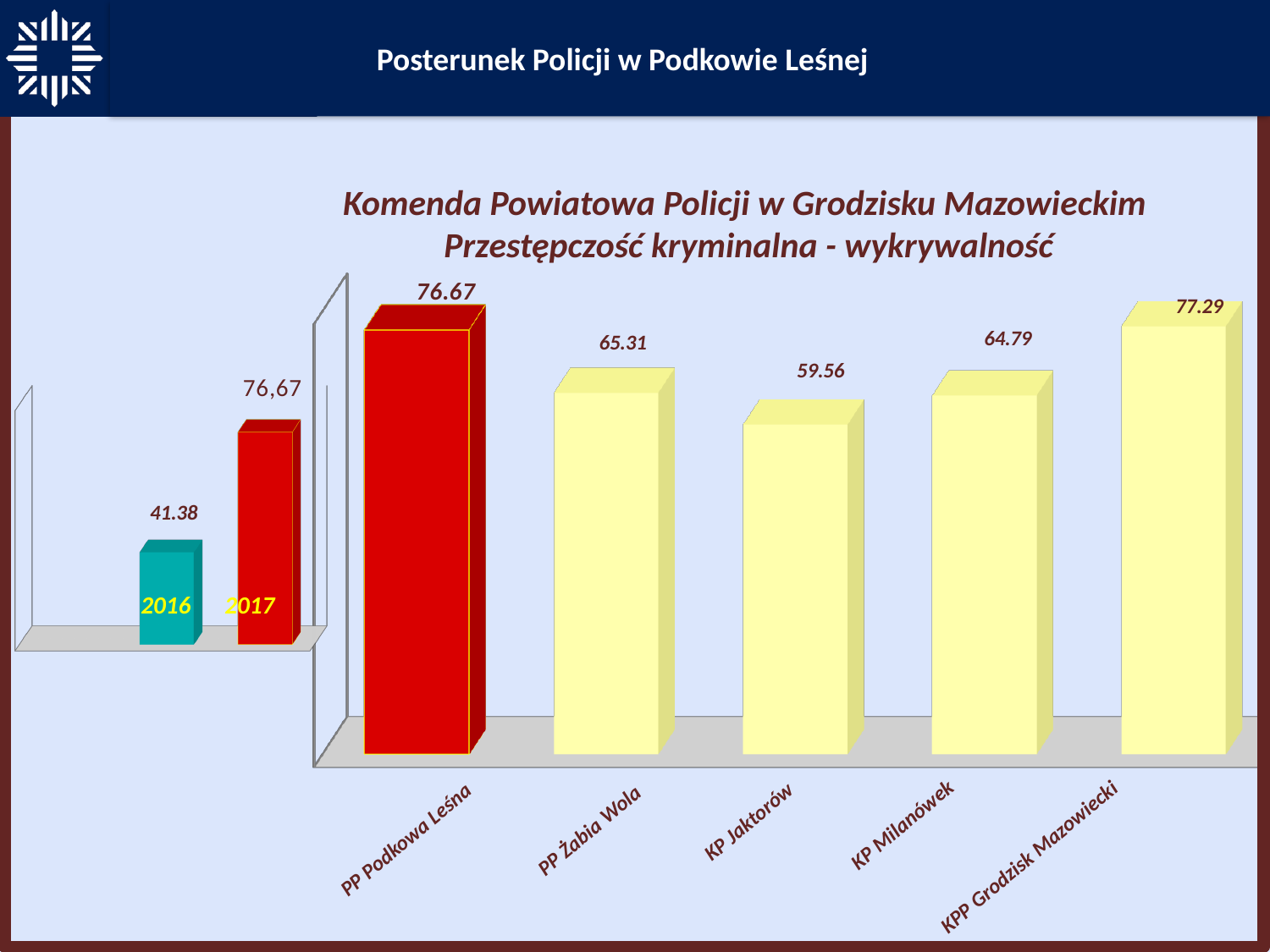
In the large chart on the right, which category has the highest value? KPP Grodzisk Mazowiecki How many categories are shown in the large chart on the right? 5 In the large chart on the right, what is the value for KP Jaktorów? 59.56 In the small chart on the left, what is the value for 2017? 76,67 In the large chart on the right, which category has the lowest value? KP Jaktorów What kind of chart is the large chart on the right? Bar chart In the small chart on the left, what is the value for 2016? 41.38 In the large chart on the right, which is larger: the value for PP Żabia Wola or the value for KP Jaktorów? PP Żabia Wola In the large chart on the right, what is the value for KPP Grodzisk Mazowiecki? 77.29 In the small chart on the left, which year has the higher value, 2016 or 2017? 2017 In the large chart on the right, what is the difference between the values for PP Żabia Wola and KP Milanówek? 0.52 In the large chart titled 'Komenda Powiatowa Policji w Grodzisku Mazowieckim Przestępczość kryminalna - wykrywalność', what is the value for PP Podkowa Leśna? 76.67